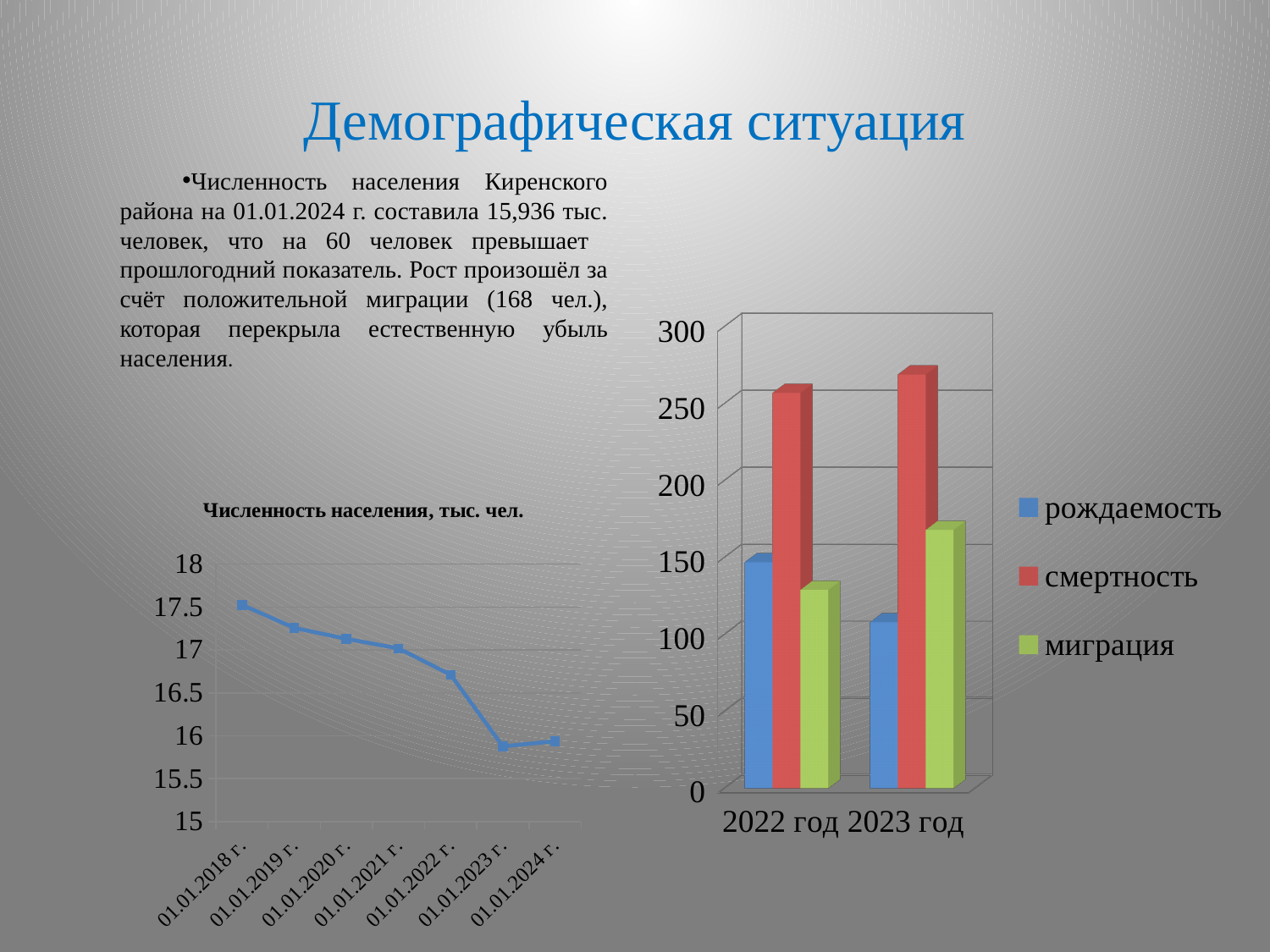
In the chart titled "Численность населения, тыс. чел.", is the value for 01.01.2022 г. greater or less than 16.5? greater In the chart on the right, is the value of рождаемость for 2023 год greater or less than 150? less In the chart titled "Численность населения, тыс. чел.", is the value for 01.01.2023 г. greater or less than 16? less How many series does the legend of the chart on the right list? 3 In the chart titled "Численность населения, тыс. чел.", do the values rise or fall from 01.01.2018 г. to 01.01.2024 г.? fall What kind of chart is the chart on the right of the slide? bar chart What kind of chart is the chart titled "Численность населения, тыс. чел."? line chart How many data points are plotted in the chart titled "Численность населения, тыс. чел."? 7 In the chart on the right, which series has the lowest bar for 2023 год? рождаемость In the chart on the right, which is larger for 2022 год: рождаемость or смертность? смертность In the chart on the right, which series has the highest bar for 2023 год? смертность